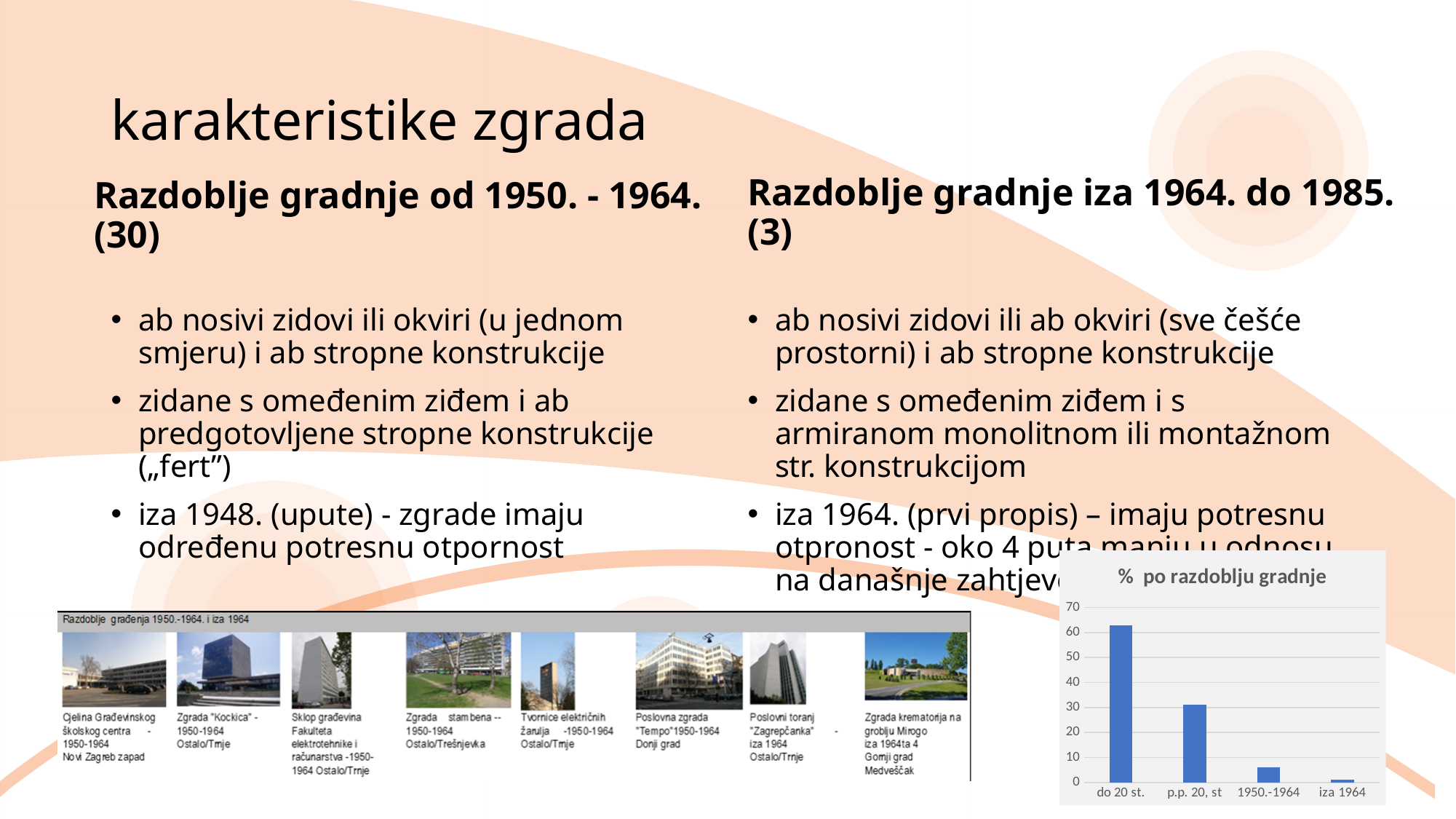
Which category has the highest value in the chart? do 20 st. Is the value for "p.p. 20, st" greater or less than 20? greater Which is larger, the value for "do 20 st." or the value for "p.p. 20, st"? do 20 st. Do the values rise or fall from left to right along the x axis? fall What kind of chart is shown on the slide? bar chart Is the value for "p.p. 20, st" greater or less than 40? less Which category has the lowest value in the chart? iza 1964 Is the value for "do 20 st." greater or less than 60? greater Which is larger, the value for "1950.-1964" or the value for "iza 1964"? 1950.-1964 What is the title of the chart? % po razdoblju gradnje How many categories are shown on the x axis of the chart? 4